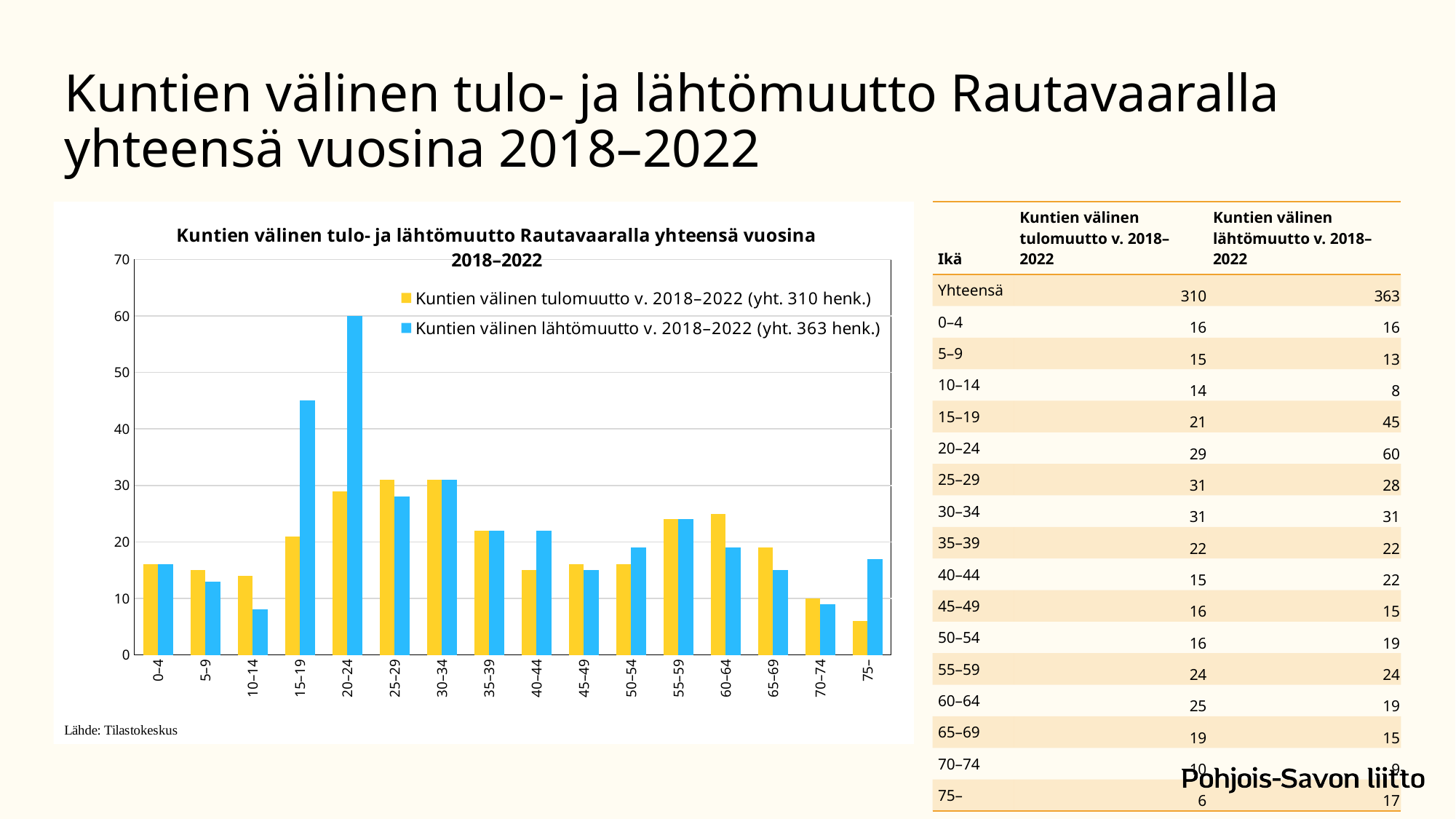
How many series does the chart legend list? 2 How many age groups are shown on the x axis of the chart? 16 Which age group has the highest value for Kuntien välinen lähtömuutto v. 2018–2022? 20–24 What is the value for Kuntien välinen lähtömuutto v. 2018–2022 in the 20–24 age group? 60 What kind of chart is shown on the slide? bar chart What total number of people does the legend give for Kuntien välinen tulomuutto v. 2018–2022? 310 henk. What is the value for Kuntien välinen tulomuutto v. 2018–2022 in the 15–19 age group? 21 In the 60–64 age group, which is larger: tulomuutto or lähtömuutto? tulomuutto What is the difference between lähtömuutto and tulomuutto in the 15–19 age group? 24 Which age group has the lowest value for Kuntien välinen tulomuutto v. 2018–2022? 75– Is the value for Kuntien välinen lähtömuutto in the 15–19 age group greater or less than 40? greater Which colour represents Kuntien välinen lähtömuutto v. 2018–2022 in the chart? blue